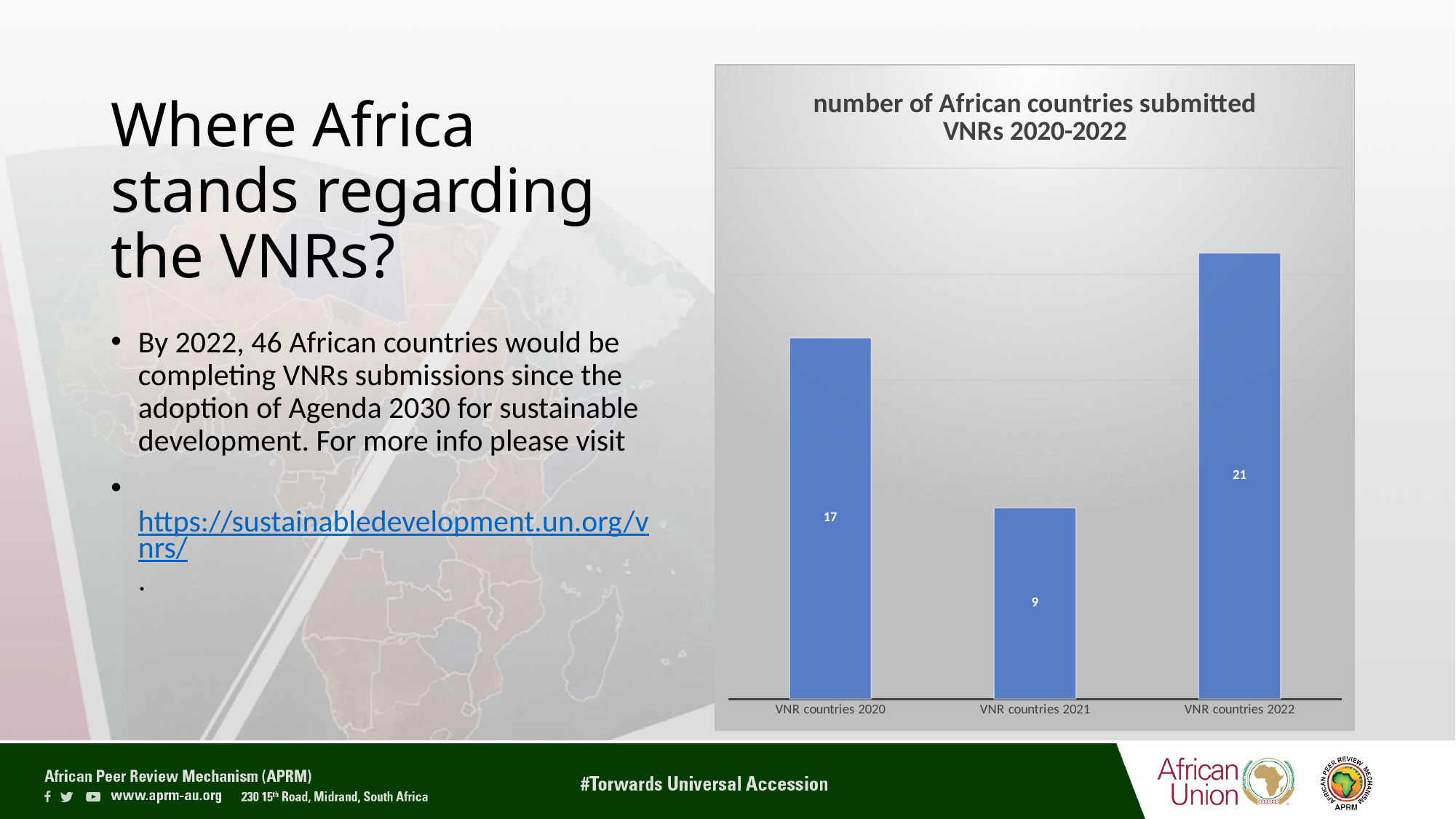
Which is larger, the value for VNR countries 2020 or VNR countries 2022? VNR countries 2022 What is the difference between the values for VNR countries 2022 and VNR countries 2021? 12 Which category has the highest value? VNR countries 2022 What is the total of the three values shown in the chart? 47 What is the difference between the values for VNR countries 2020 and VNR countries 2021? 8 What is the title of the chart? number of African countries submitted VNRs 2020-2022 How many categories are shown in the chart? 3 Which category has the lowest value? VNR countries 2021 What kind of chart is shown on the slide? Bar chart What is the value for VNR countries 2020? 17 What is the value for VNR countries 2021? 9 What is the value for VNR countries 2022? 21